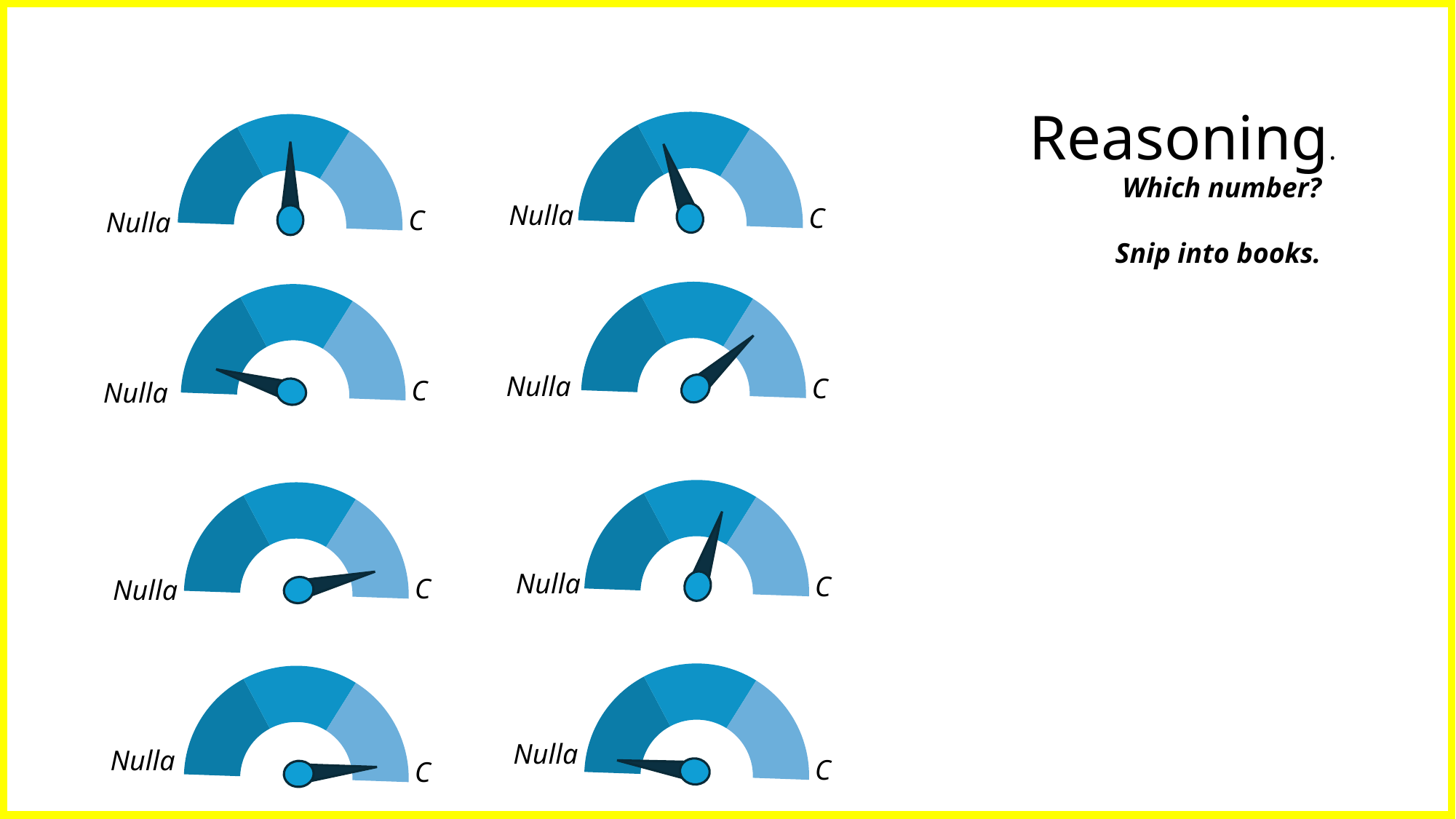
What label appears at the left end of each gauge? Nulla Which gauge has its needle pointing closest to the "C" end? the bottom-left gauge What kind of charts are shown on the slide? gauge charts In the third-row left gauge, is the needle closer to the "Nulla" end or the "C" end? C How many gauge charts are on the slide? 8 What label appears at the right end of each gauge? C In the top-right gauge, is the needle closer to the "Nulla" end or the "C" end? Nulla In the second-row right gauge, is the needle closer to the "Nulla" end or the "C" end? C How many coloured segments does each gauge have? 3 Which gauge has its needle pointing closest to the "Nulla" end? the bottom-right gauge